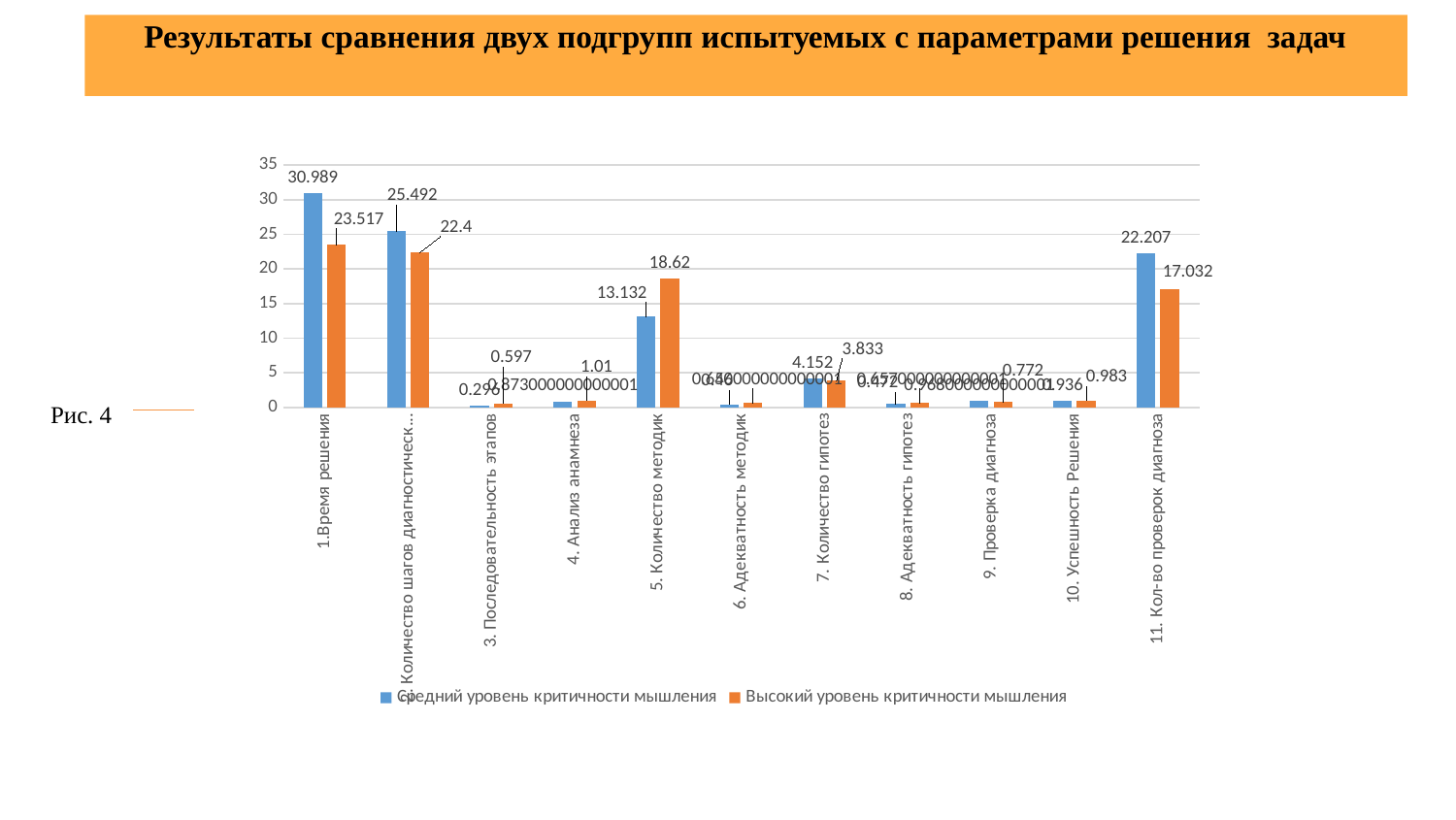
How many series does the legend list? 2 For 5. Количество методик, which series has the larger value? Высокий уровень критичности мышления What is the difference between the two series for 5. Количество методик? 5.488 What is the value for 1.Время решения in the Высокий уровень критичности мышления series? 23.517 How many categories are shown on the x axis? 11 Is the value for 11. Кол-во проверок диагноза in the Высокий уровень критичности мышления series greater or less than 20? less What is the value for 5. Количество методик in the Высокий уровень критичности мышления series? 18.62 Which category has the highest value in the Средний уровень критичности мышления series? 1.Время решения What is the value for 11. Кол-во проверок диагноза in the Средний уровень критичности мышления series? 22.207 What is the difference between the two series for 1.Время решения? 7.472 What is the value for 1.Время решения in the Средний уровень критичности мышления series? 30.989 What is the value for 7. Количество гипотез in the Высокий уровень критичности мышления series? 3.833